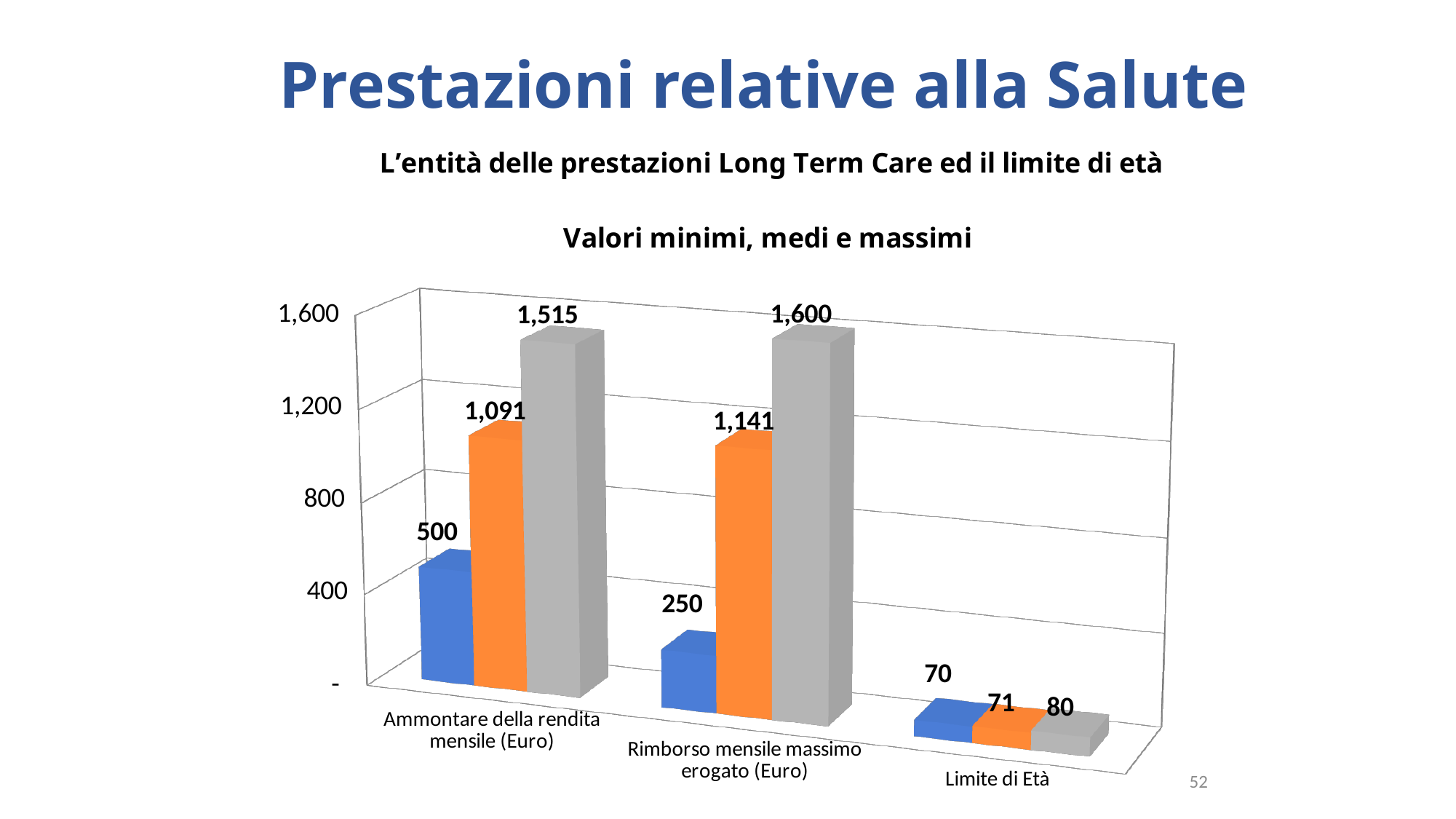
What is the value of the orange (medium) bar for 'Ammontare della rendita mensile (Euro)'? 1,091 Which category has the highest grey (maximum) bar? Rimborso mensile massimo erogato (Euro) What is the value of the grey (maximum) bar for 'Rimborso mensile massimo erogato (Euro)'? 1,600 How many categories are shown on the x axis of the chart? 3 What is the chart's title? L’entità delle prestazioni Long Term Care ed il limite di età Valori minimi, medi e massimi Which category has the lowest blue (minimum) bar? Limite di Età What is the value of the blue (minimum) bar for 'Ammontare della rendita mensile (Euro)'? 500 What is the value of the orange (medium) bar for 'Limite di Età'? 71 What is the difference between the grey (maximum) and blue (minimum) bars for 'Ammontare della rendita mensile (Euro)'? 1,015 Which is larger: the orange bar for 'Ammontare della rendita mensile (Euro)' or the orange bar for 'Rimborso mensile massimo erogato (Euro)'? Rimborso mensile massimo erogato (Euro) What type of chart is shown on the slide? bar chart Is the blue (minimum) bar for 'Rimborso mensile massimo erogato (Euro)' greater or less than 400? less